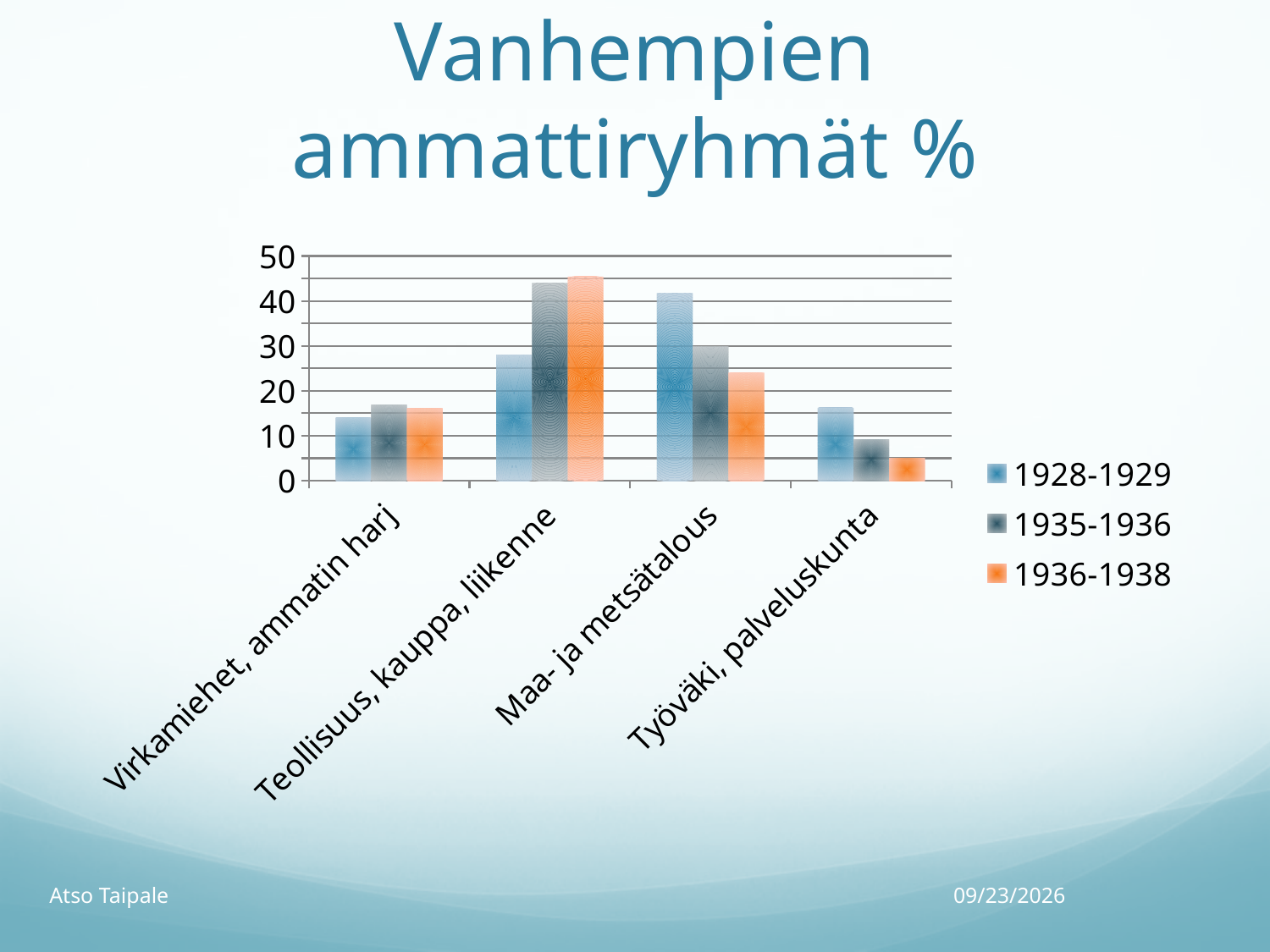
How many occupational categories are shown on the x axis? 4 How many series does the legend list? 3 Which category has the lowest value for the 1936-1938 series? Työväki, palveluskunta Is the 1928-1929 value for Maa- ja metsätalous greater or less than 40? greater Is the 1928-1929 value for Teollisuus, kauppa, liikenne greater or less than 30? less What kind of chart is shown on the slide? bar chart Is the 1936-1938 value for Työväki, palveluskunta greater or less than 10? less What is the title of the chart on the slide? Vanhempien ammattiryhmät % For Maa- ja metsätalous, which is larger: the 1928-1929 value or the 1936-1938 value? 1928-1929 Which category has the highest value for the 1935-1936 series? Teollisuus, kauppa, liikenne Do the values for Maa- ja metsätalous rise or fall from the 1928-1929 series to the 1936-1938 series? fall Which category has the highest value for the 1928-1929 series? Maa- ja metsätalous